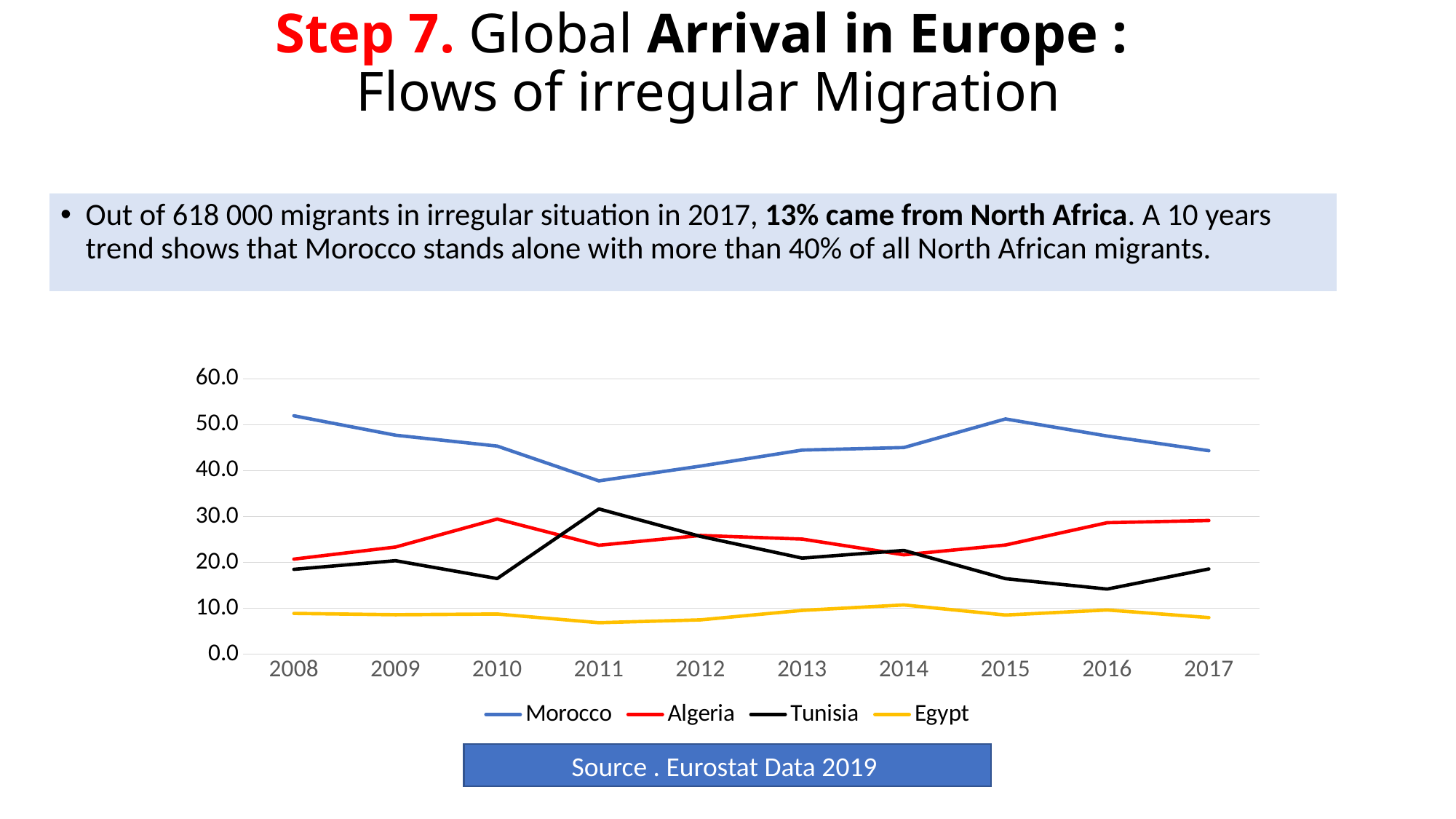
Is the value for Morocco in 2011 greater or less than 40? less In 2010, which is larger: the value for Algeria or the value for Tunisia? Algeria What colour is the line for Tunisia in the chart? black Which country has the highest value in 2017? Morocco How many years are shown along the x axis of the chart? 10 How many series does the chart legend list? 4 In which year does Tunisia reach its highest value? 2011 Is the value for Tunisia in 2011 greater or less than 30? greater What kind of chart is shown on the slide? line chart Does the Morocco line rise or fall from 2008 to 2011? fall Is the value for Egypt in 2011 greater or less than 10? less Which country has the lowest value in 2008? Egypt